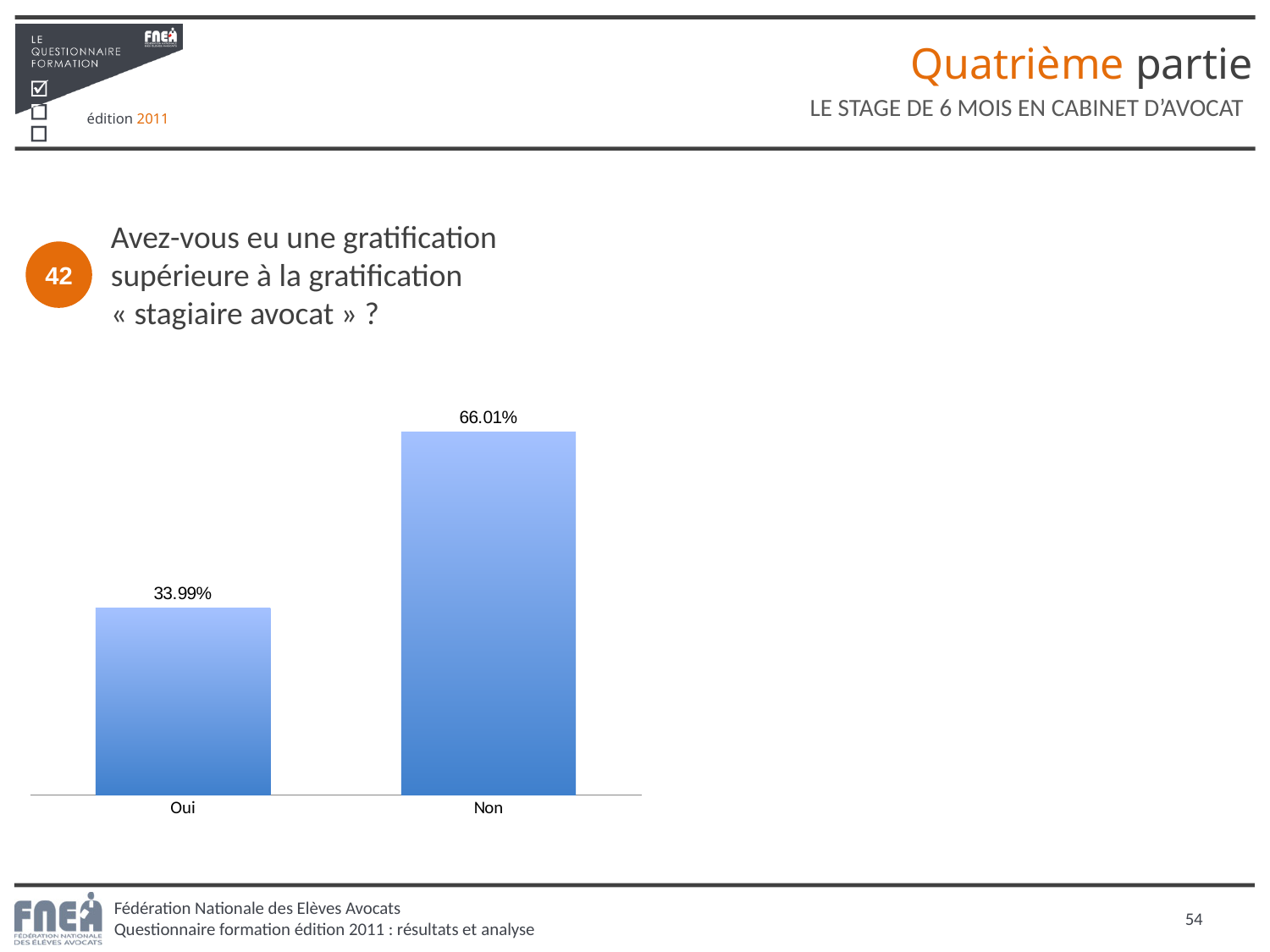
What is the total of the two values shown in the chart? 100% What kind of chart is shown on the slide? Bar chart Which is larger, the value for Oui or the value for Non? Non Which category has the lowest value? Oui What question number is shown next to the chart's question text? 42 What colour are the bars in the chart? Blue What is the value for Non? 66.01% What is the difference between the values for Non and Oui? 32.02% What is the value for Oui? 33.99% Which category has the highest value? Non How many categories are shown in the chart? 2